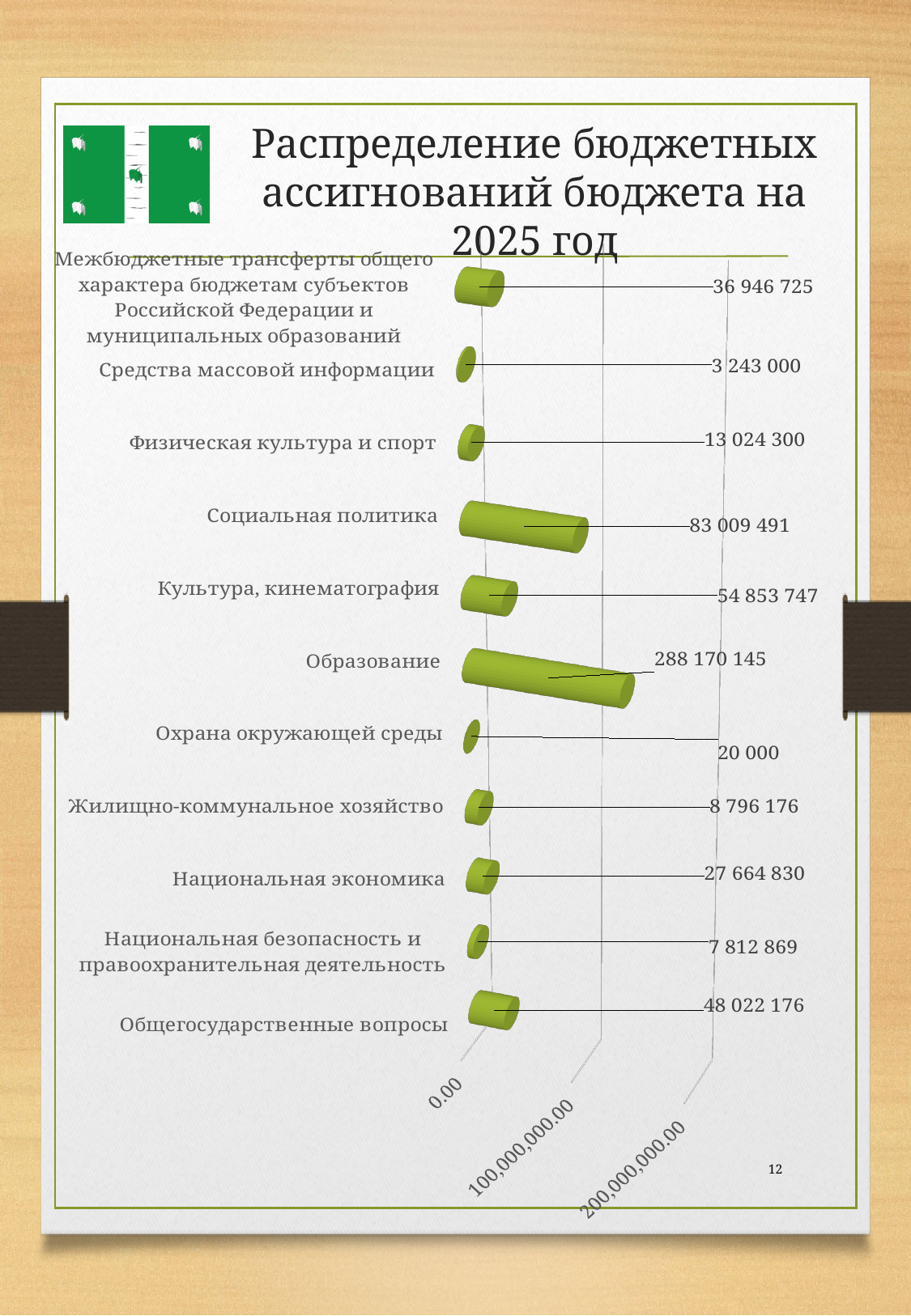
What is the value for Охрана окружающей среды? 20 000 What is the difference between the values for Образование and Социальная политика? 205 160 654 Which category has the highest value? Образование What kind of chart is shown on the slide? Bar chart Which category has the lowest value? Охрана окружающей среды How many categories are shown in the chart? 11 What is the value for Социальная политика? 83 009 491 What is the title of the slide? Распределение бюджетных ассигнований бюджета на 2025 год What is the value for Образование? 288 170 145 Which is larger, the value for Культура, кинематография or the value for Общегосударственные вопросы? Культура, кинематография What is the value for Общегосударственные вопросы? 48 022 176